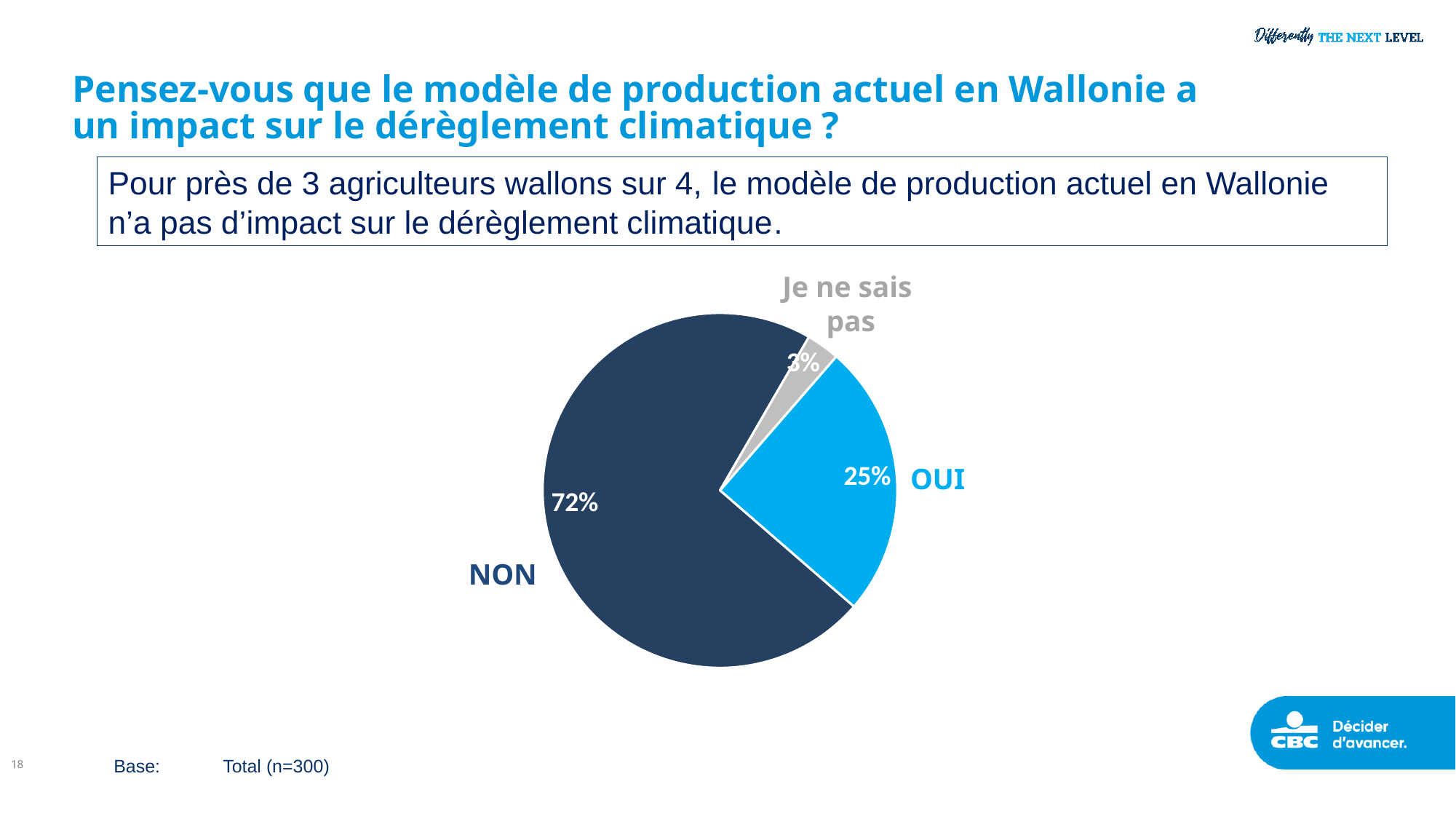
Which response has the smallest share of the pie? Je ne sais pas Which is larger, the share for OUI or the share for 'Je ne sais pas'? OUI What is the difference in percentage points between NON and OUI? 47 What percentage of respondents answered OUI? 25% Which response has the largest share of the pie? NON What colour is the OUI slice of the pie? Light blue How many slices does the pie chart have? 3 What percentage of respondents answered 'Je ne sais pas'? 3% What is the difference in percentage points between OUI and 'Je ne sais pas'? 22 What percentage of respondents answered NON? 72% What is the base (sample size) stated at the bottom of the slide? Total (n=300) What kind of chart is shown on the slide? Pie chart